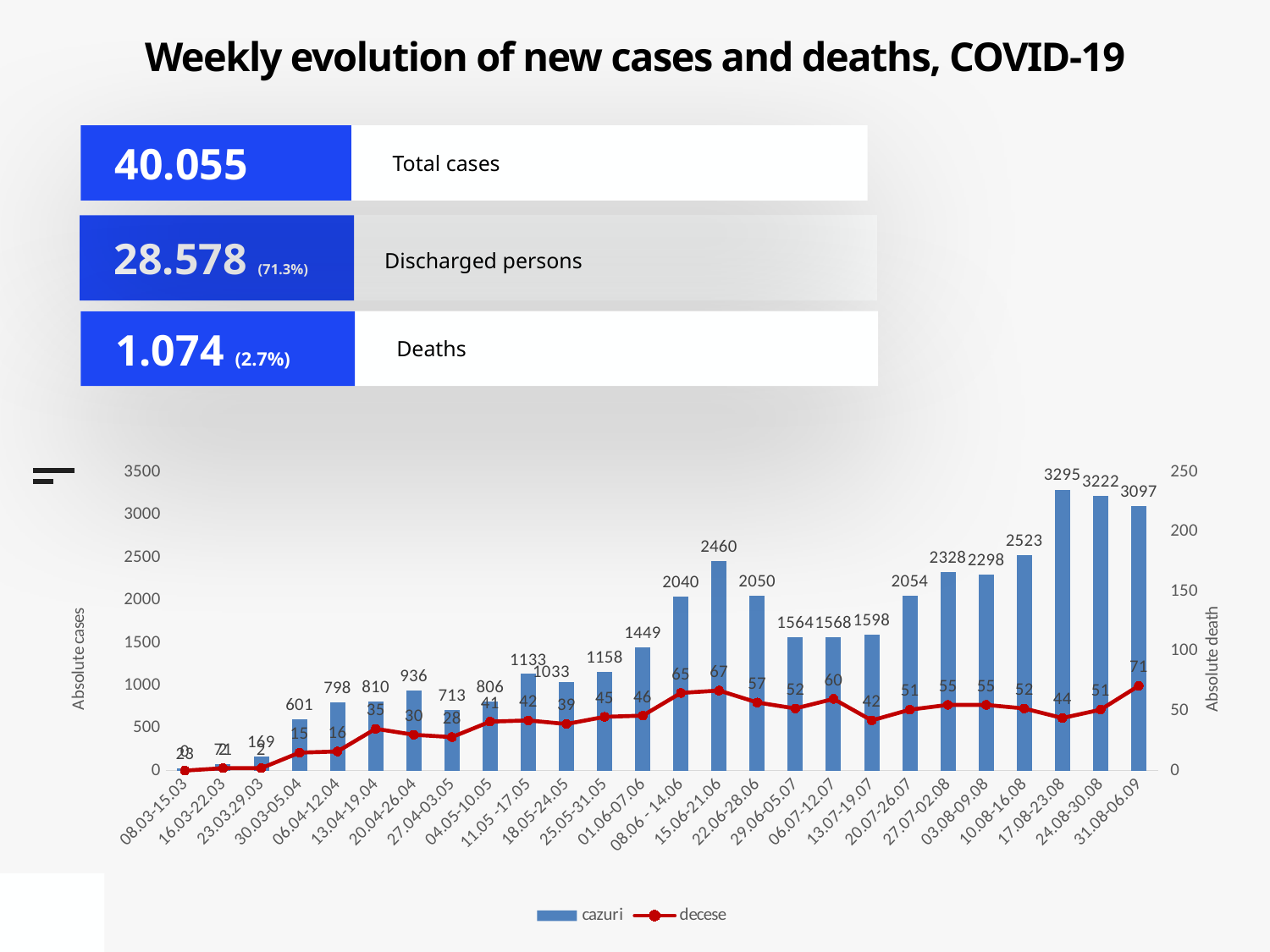
Which week has the highest number of cases (cazuri)? 17.08-23.08 What kind of chart is shown on the slide? A combined bar and line chart What is the difference in cases between the weeks 17.08-23.08 and 24.08-30.08? 73 What are the two entries in the chart legend? cazuri and decese What is the number of cases (cazuri) for the week 13.07-19.07? 1598 Which week has more cases, 01.06-07.06 or 25.05-31.05? 01.06-07.06 How many weekly periods are shown on the x axis of the chart? 26 What is the difference in deaths between the weeks 31.08-06.09 and 24.08-30.08? 20 What is the number of cases (cazuri) for the week 15.06-21.06? 2460 Which week has the highest number of deaths (decese)? 31.08-06.09 How many series does the chart legend list? 2 What is the number of deaths (decese) for the week 31.08-06.09? 71